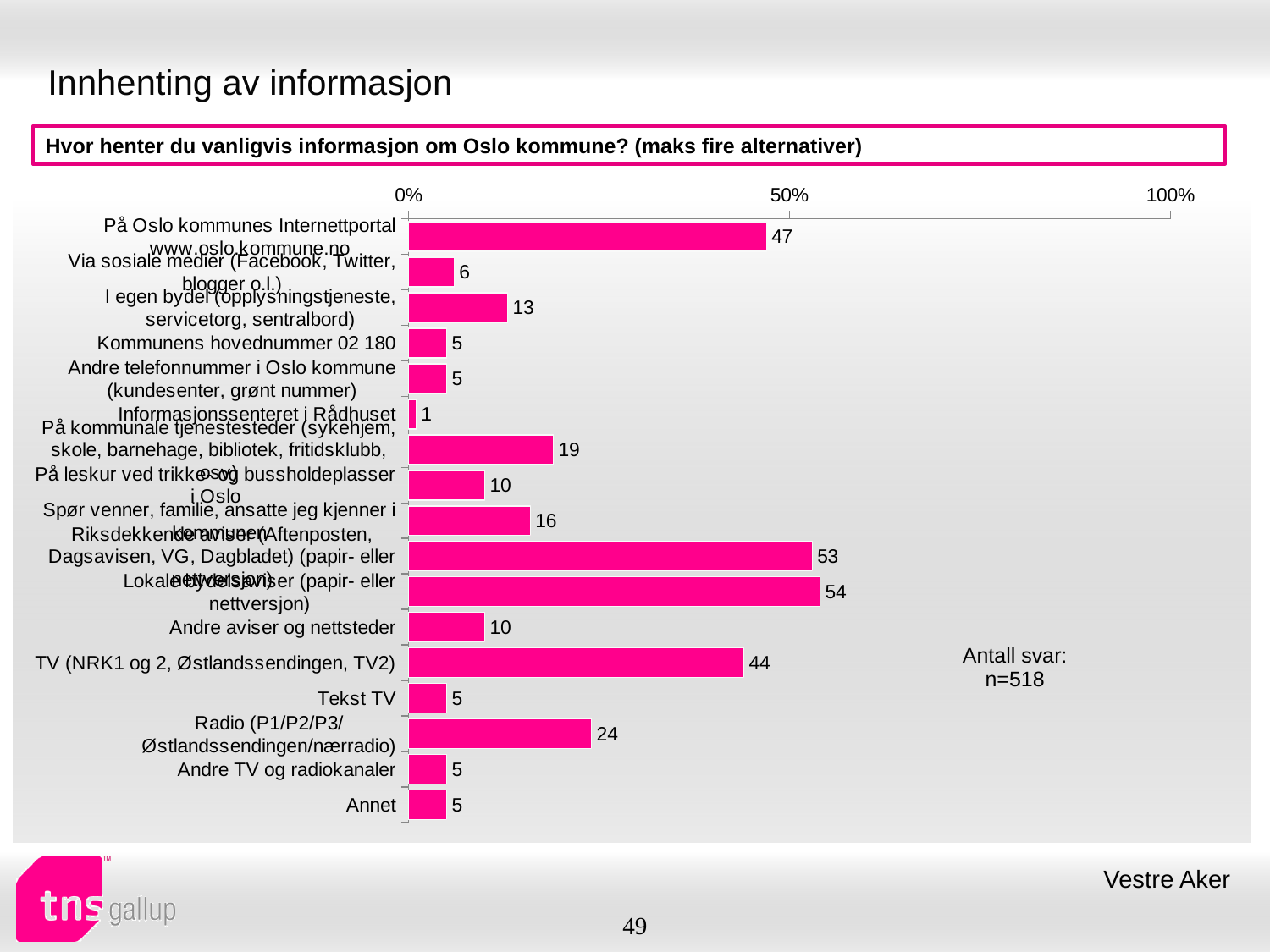
What type of chart is shown on the slide? bar chart What is the value for "Radio (P1/P2/P3/Østlandssendingen/nærradio)"? 24 How many categories are shown in the chart? 17 What is the value for "På Oslo kommunes Internettportal www.oslo.kommune.no"? 47 Is the value for "TV (NRK1 og 2, Østlandssendingen, TV2)" greater or less than 50%? less What is the difference between the values for "På Oslo kommunes Internettportal www.oslo.kommune.no" and "TV (NRK1 og 2, Østlandssendingen, TV2)"? 3 What is the value for "Kommunens hovednummer 02 180"? 5 What is the value for "Andre aviser og nettsteder"? 10 What is the number of respondents (n) stated on the slide? n=518 Which is larger, the value for "Radio (P1/P2/P3/Østlandssendingen/nærradio)" or the value for "Tekst TV"? Radio (P1/P2/P3/Østlandssendingen/nærradio) What is the value for "TV (NRK1 og 2, Østlandssendingen, TV2)"? 44 Which category has the lowest value? Informasjonssenteret i Rådhuset